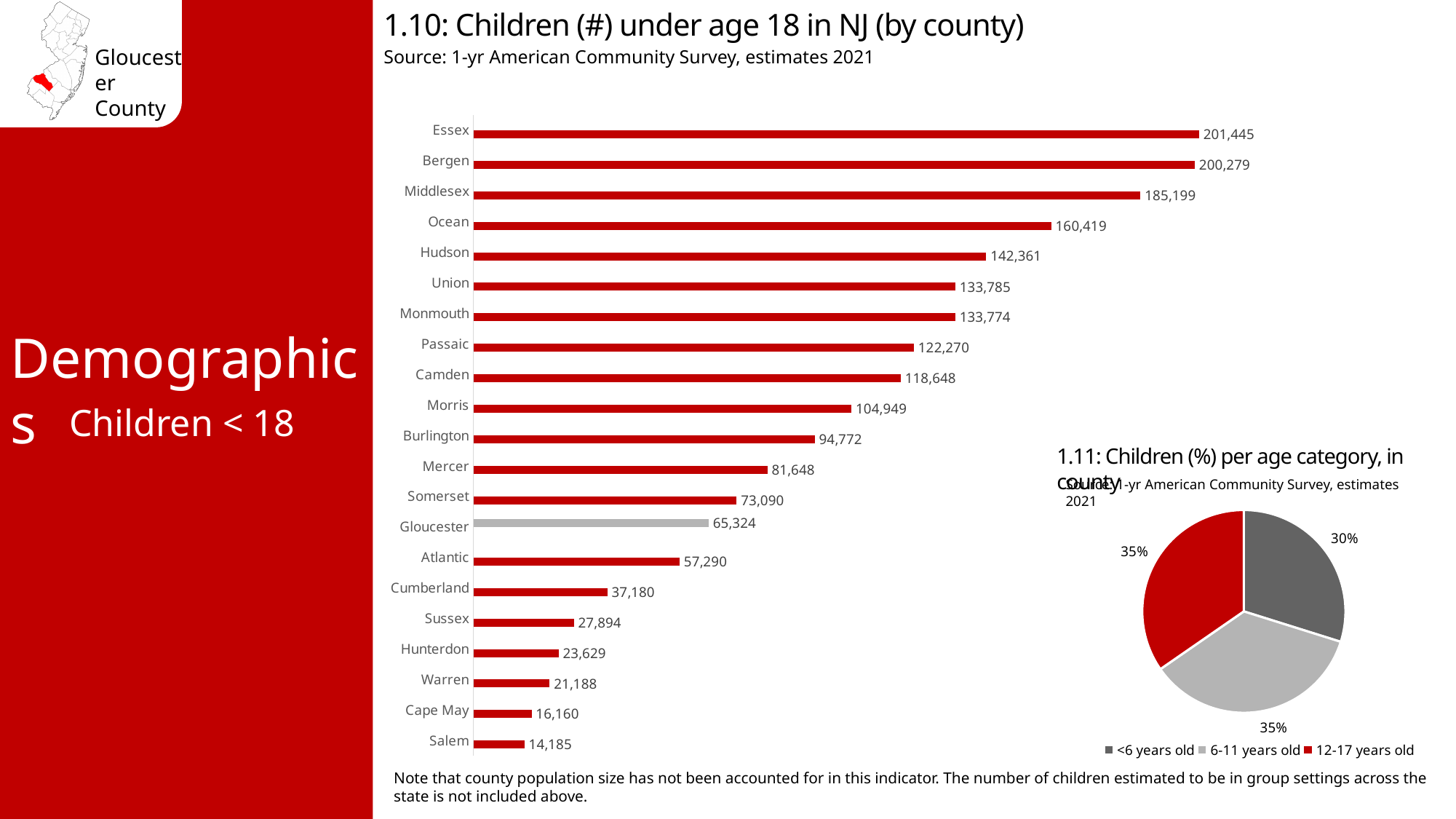
How many categories does the legend of the pie chart '1.11: Children (%) per age category, in county' list? 3 In the chart '1.10: Children (#) under age 18 in NJ (by county)', what is the difference between the values for Camden and Gloucester? 53,324 In the chart '1.10: Children (#) under age 18 in NJ (by county)', what is the difference between the values for Essex and Bergen? 1,166 How many counties are shown in the chart '1.10: Children (#) under age 18 in NJ (by county)'? 21 In the chart '1.10: Children (#) under age 18 in NJ (by county)', which county's bar is coloured grey instead of red? Gloucester In the pie chart '1.11: Children (%) per age category, in county', what share of children are under 6 years old? 30% In the chart '1.10: Children (#) under age 18 in NJ (by county)', what is the value for Hudson? 142,361 In the chart '1.10: Children (#) under age 18 in NJ (by county)', which has more children under 18, Union or Monmouth? Union In the chart '1.10: Children (#) under age 18 in NJ (by county)', how many children under age 18 are in Gloucester County? 65,324 In the chart '1.10: Children (#) under age 18 in NJ (by county)', which county has the highest number of children under 18? Essex What type of chart is '1.10: Children (#) under age 18 in NJ (by county)'? Bar chart In the chart '1.10: Children (#) under age 18 in NJ (by county)', which county has the lowest number of children under 18? Salem